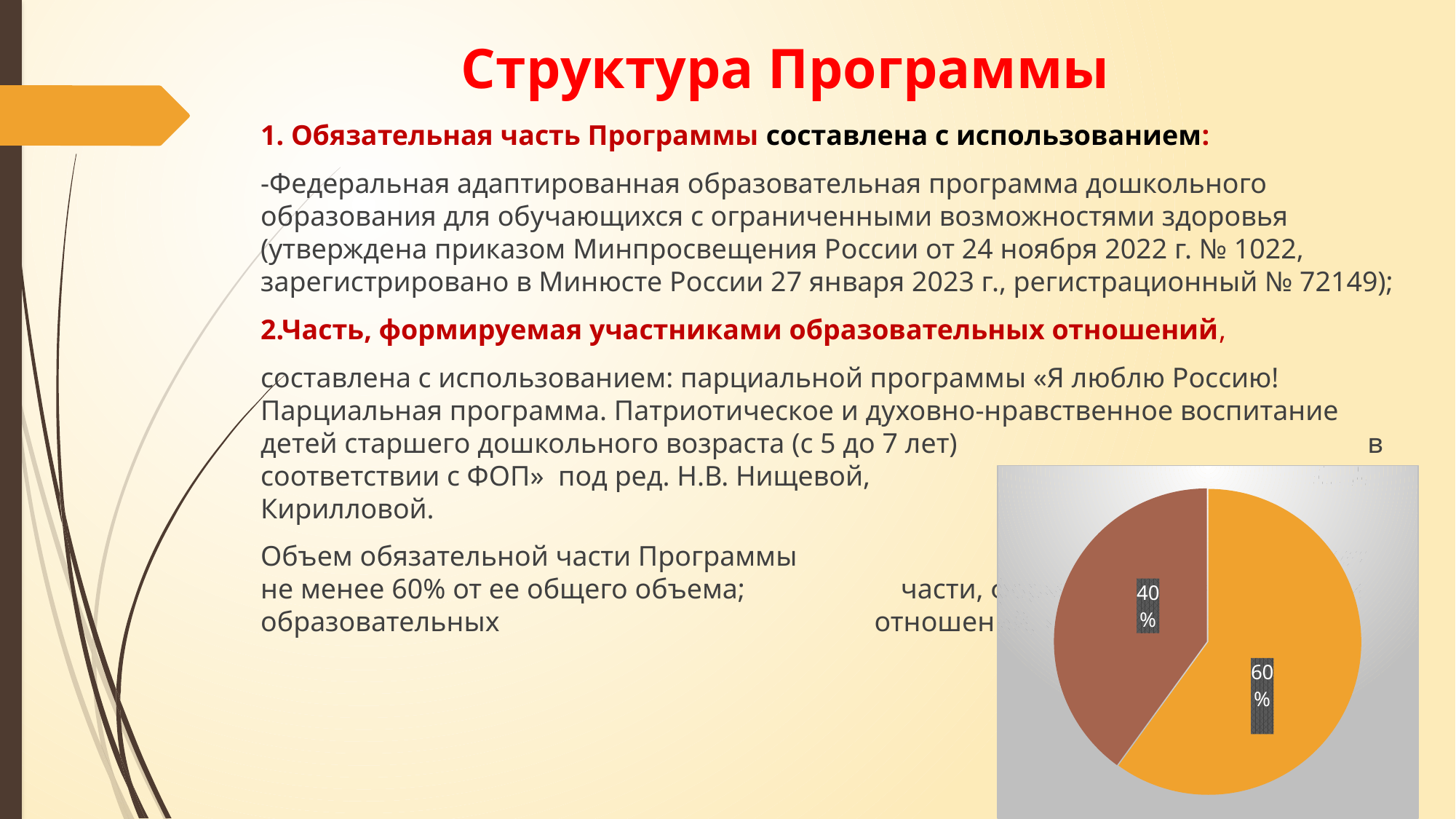
Which slice of the pie chart is the smallest? the brown slice (40%) What share of the pie does the orange slice represent? 60% Which slice of the pie chart is the largest? the orange slice (60%) Which is larger in the pie chart, the orange slice or the brown slice? the orange slice What kind of chart is shown on the slide? pie chart What value is labelled on the brown slice of the pie chart? 40% How many slices does the pie chart have? 2 Is the value of the brown slice greater or less than 50%? less What value is labelled on the orange slice of the pie chart? 60% What colour is the slice labelled 40% in the pie chart? brown What is the difference between the two slices of the pie chart? 20% What do the two slices of the pie chart add up to? 100%